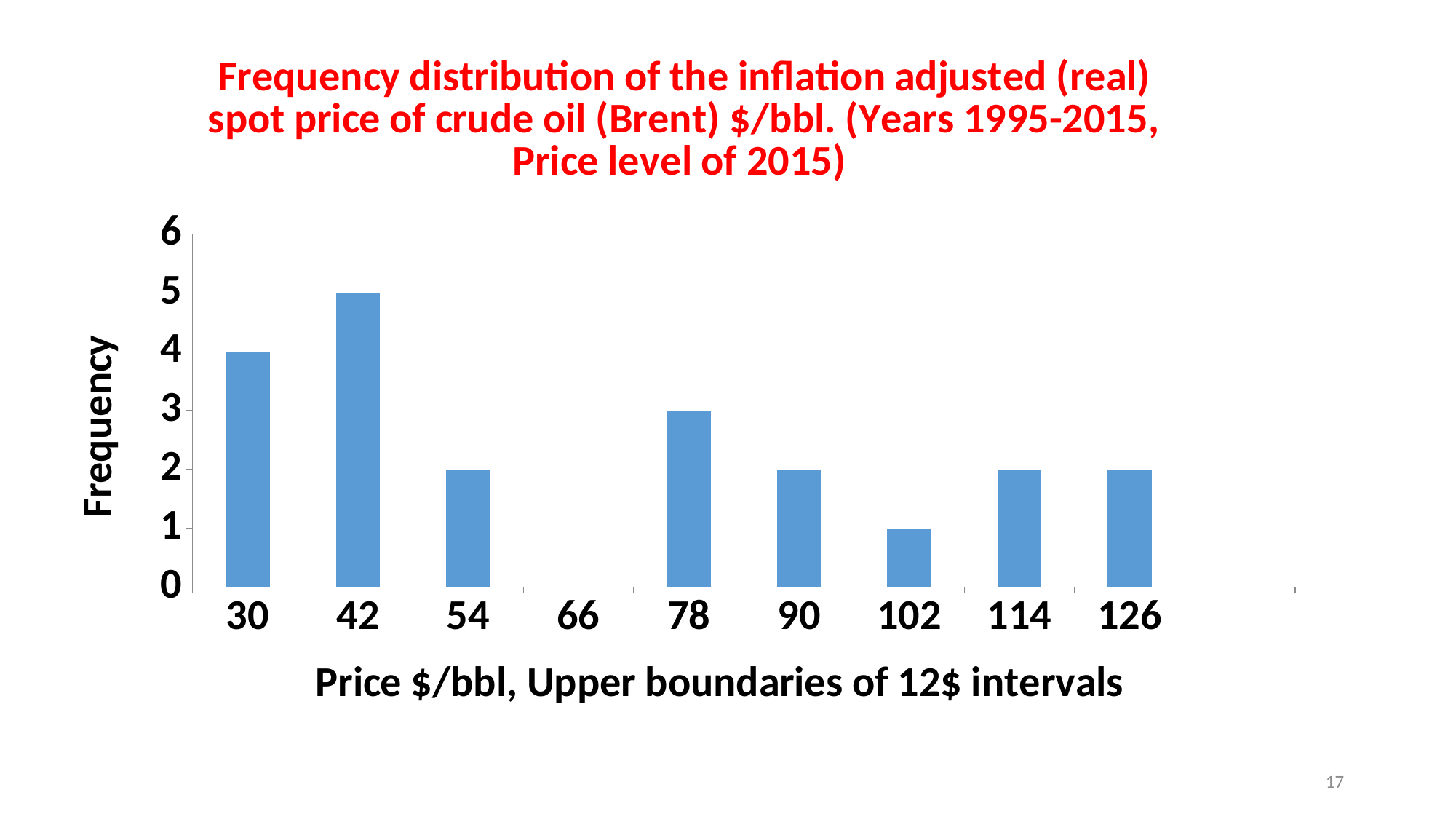
What kind of chart is shown on the slide? Bar chart How many price intervals are shown on the x axis? 9 What is the frequency for the 66 price interval? 0 What is the frequency for the 78 price interval? 3 What is the frequency for the 30 price interval? 4 What is the frequency for the 102 price interval? 1 Which has a higher frequency, the 78 interval or the 90 interval? 78 What is the frequency for the 42 price interval? 5 Which price interval has the lowest frequency? 66 What is the label of the y axis? Frequency What is the difference between the frequency for 42 and the frequency for 30? 1 Which price interval has the highest frequency? 42